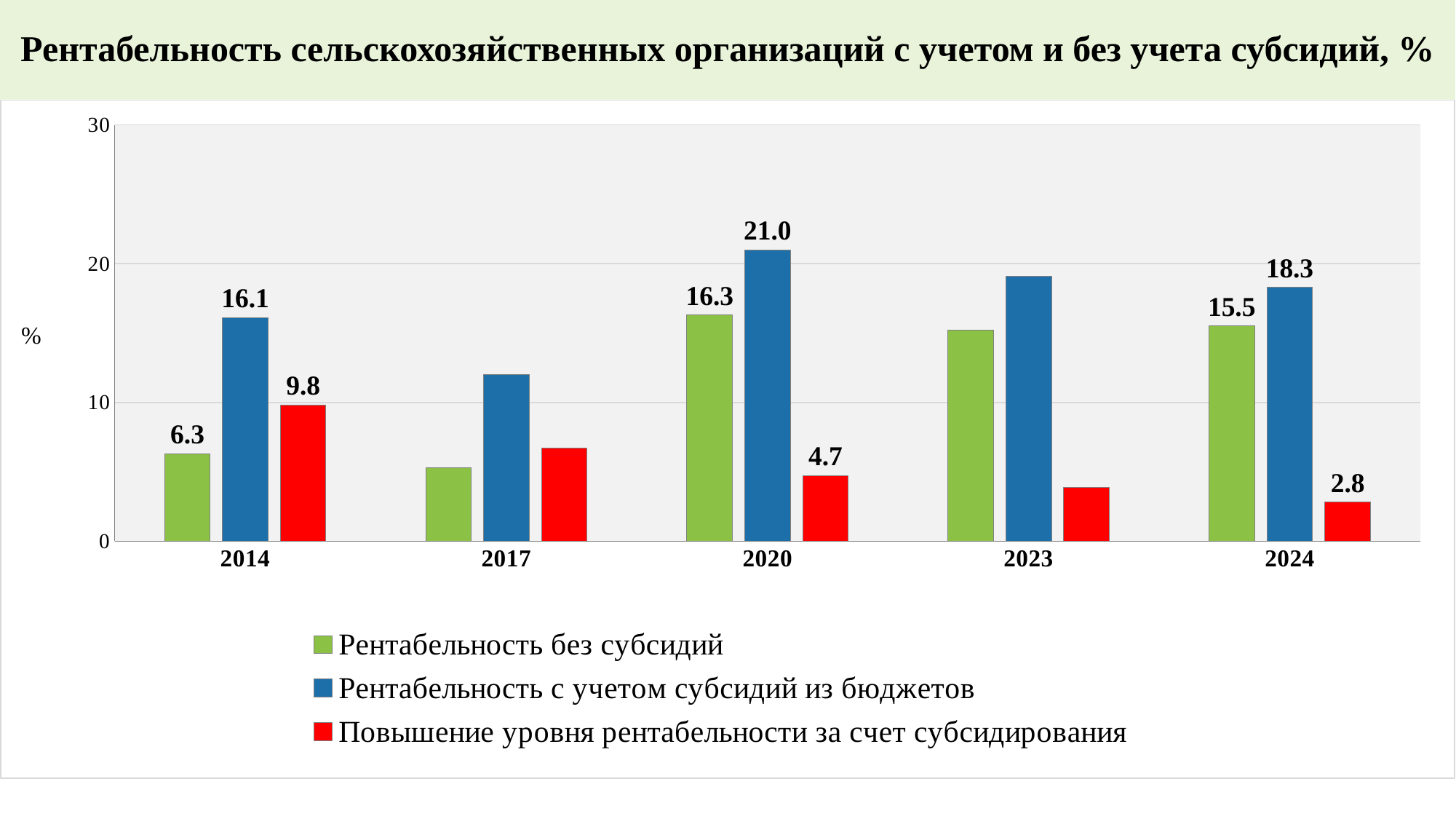
In which year is 'Повышение уровня рентабельности за счет субсидирования' lowest? 2024 What kind of chart is shown on the slide? bar chart What is the value of 'Рентабельность с учетом субсидий из бюджетов' for 2020? 21.0 Which is larger in 2020: 'Рентабельность без субсидий' or 'Повышение уровня рентабельности за счет субсидирования'? Рентабельность без субсидий What is the value of 'Рентабельность с учетом субсидий из бюджетов' for 2024? 18.3 How many series does the legend list? 3 What is the value of 'Повышение уровня рентабельности за счет субсидирования' for 2024? 2.8 What is the value of 'Рентабельность без субсидий' for 2014? 6.3 How many years are shown on the x axis? 5 What is the difference between 'Рентабельность с учетом субсидий из бюджетов' and 'Рентабельность без субсидий' in 2014? 9.8 Is the value of 'Рентабельность с учетом субсидий из бюджетов' for 2017 greater or less than 10? greater In which year is 'Рентабельность с учетом субсидий из бюджетов' highest? 2020